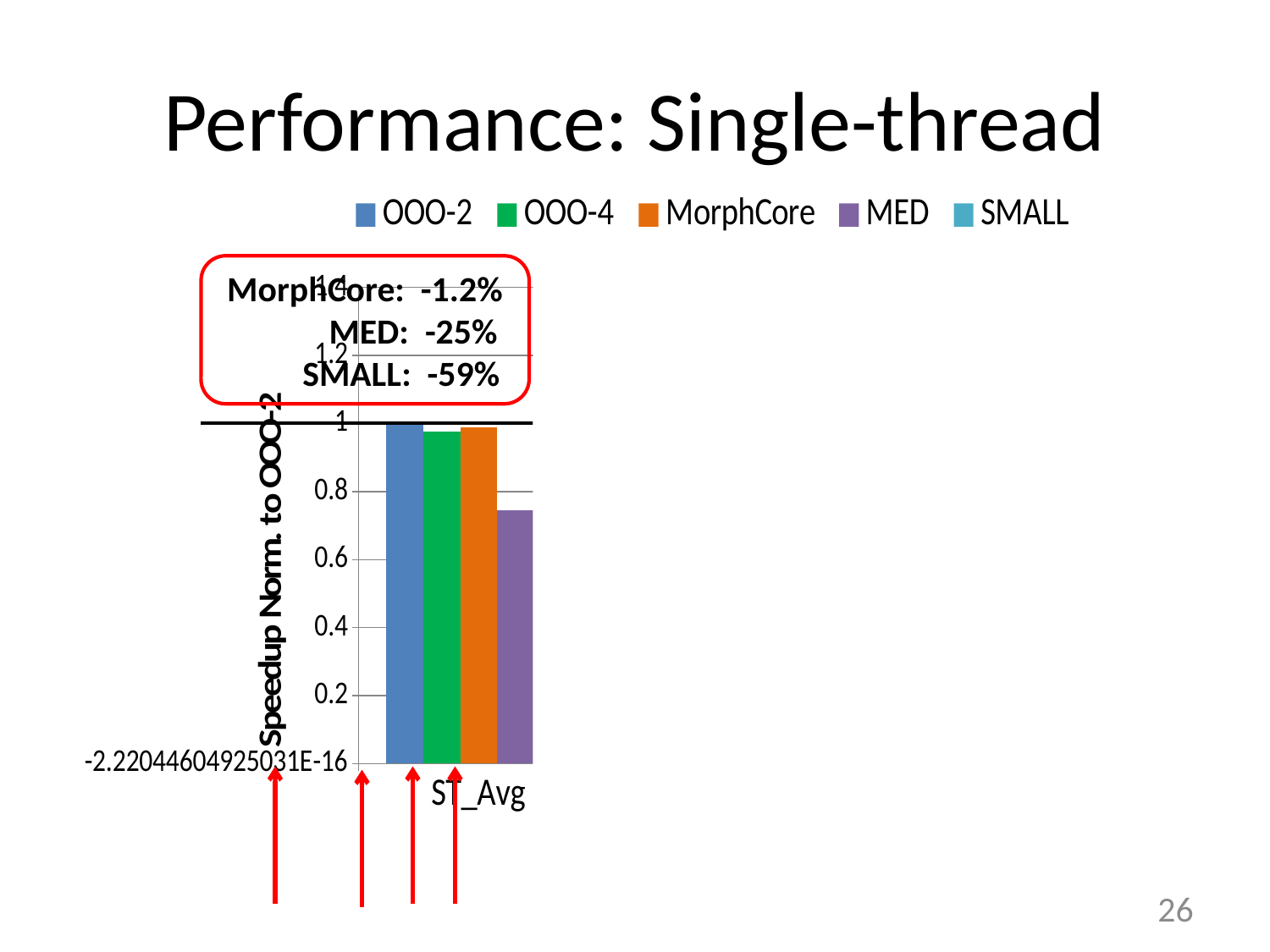
What kind of chart is shown on the slide? bar chart Is the value for OOO-4 greater or less than 0.8? greater What is the category label on the x axis? ST_Avg Which is larger, the value for OOO-2 or the value for MED? OOO-2 What is the title of the y axis? Speedup Norm. to OOO-2 Is the value for MorphCore greater or less than 0.8? greater How many series does the legend list? 5 What is the value for OOO-2 in the ST_Avg category? 1 How many categories are shown on the x axis? 1 Is the value for MED greater or less than 0.8? less Which is larger, the value for MorphCore or the value for MED? MorphCore